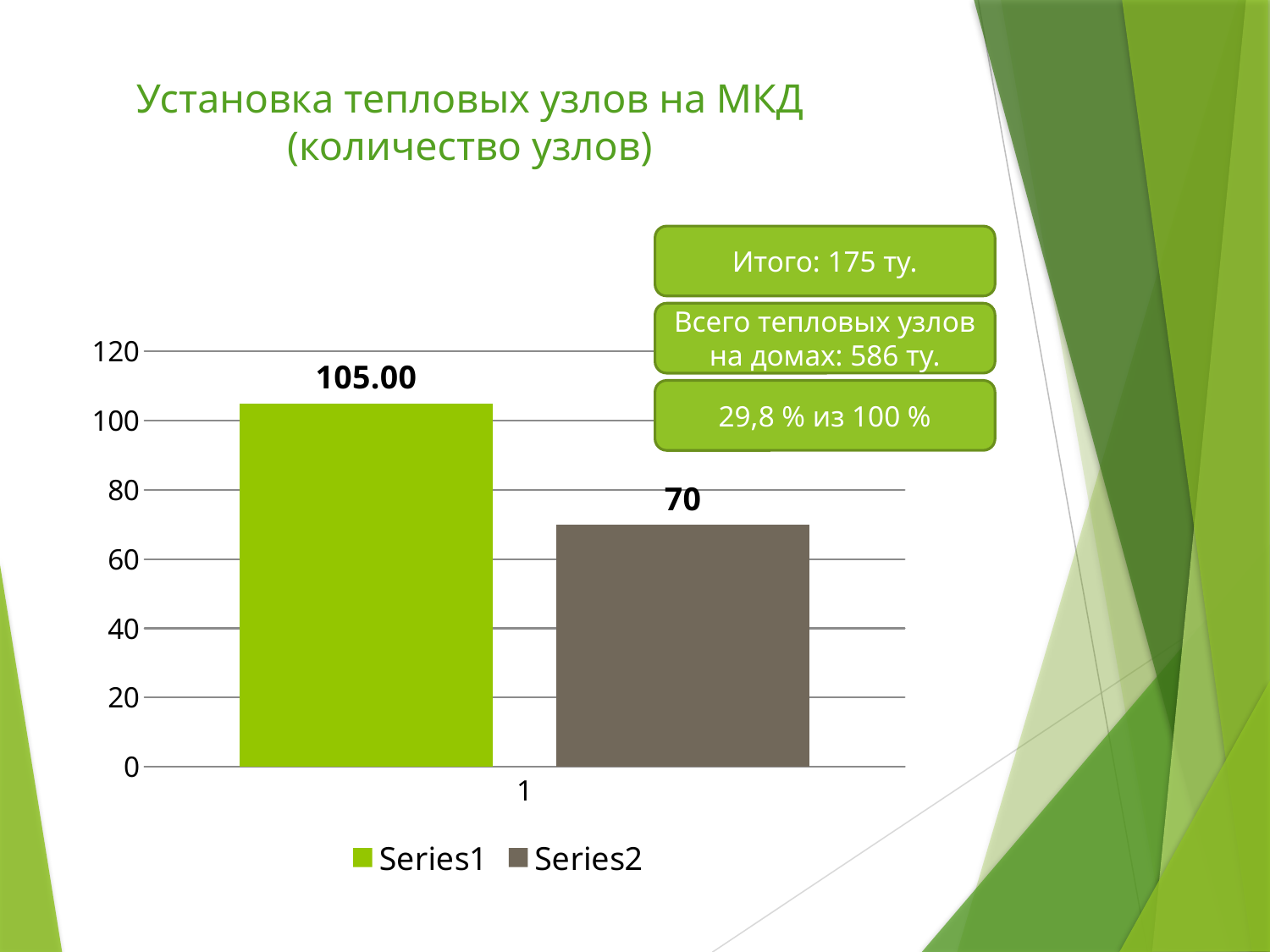
What kind of chart is shown on the slide? Bar chart What is the difference between the Series1 value and the Series2 value? 35 What colour is the Series1 bar in the chart? Green What is the highest value shown on the vertical axis of the chart? 120 Is the value for Series2 greater or less than 80? less Which series has the lowest value in the chart? Series2 What is the value of Series1 in the chart? 105.00 What is the category label shown on the horizontal axis? 1 What is the value of Series2 in the chart? 70 Is the value for Series1 greater or less than 100? greater How many series does the legend list? 2 Which series has the higher value, Series1 or Series2? Series1